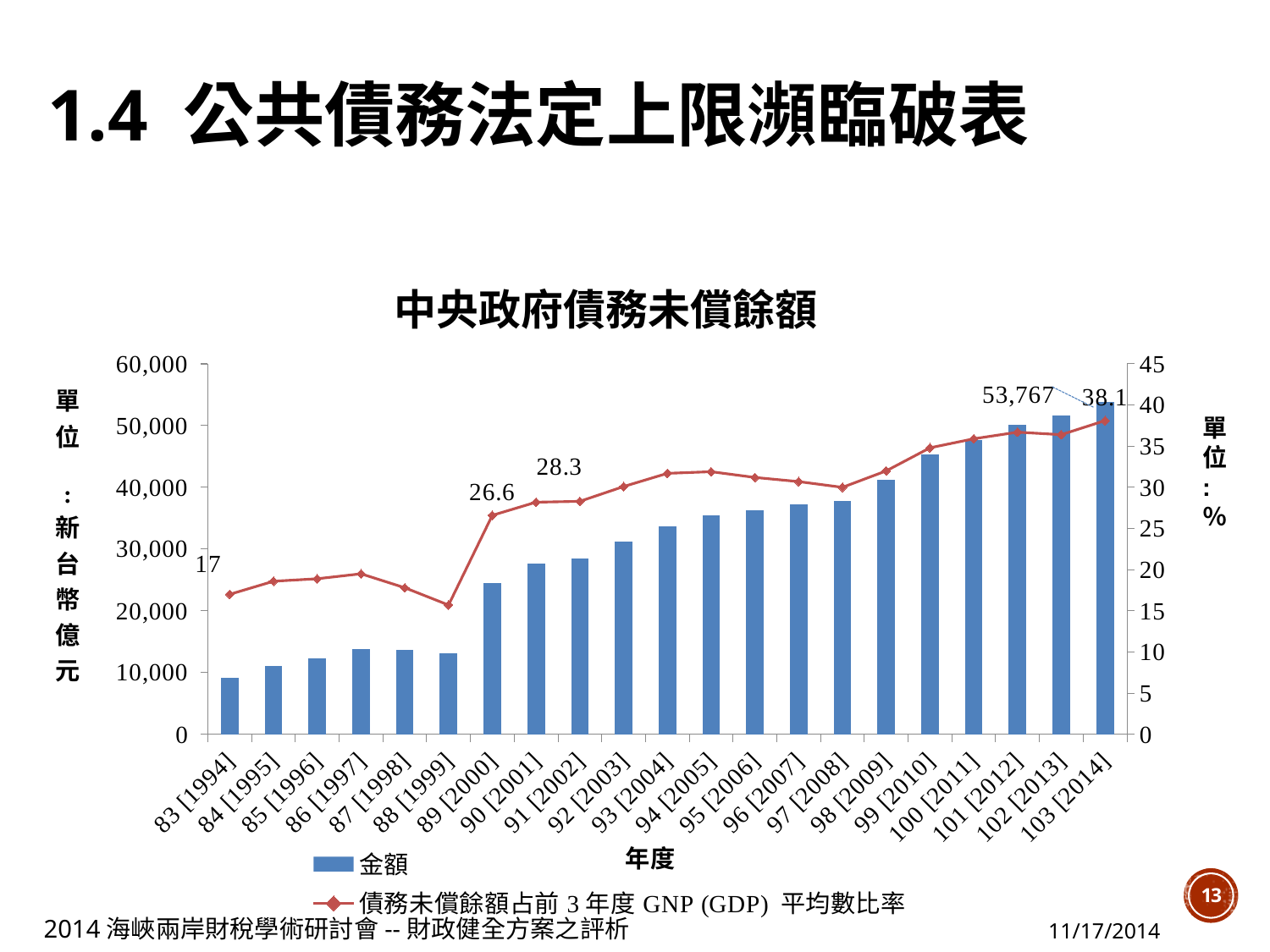
Which year has the highest 金額 bar? 103 [2014] What is the 金額 value for 103 [2014]? 53,767 What is the 債務未償餘額占前 3 年度 GNP (GDP) 平均數比率 value for 89 [2000]? 26.6 Is the 金額 value for 83 [1994] greater or less than 10,000? less Do the 金額 bars generally rise or fall from 83 [1994] to 103 [2014]? rise What is the 債務未償餘額占前 3 年度 GNP (GDP) 平均數比率 value for 83 [1994]? 17 How many years are shown on the x axis? 21 Which year has the lowest 金額 bar? 83 [1994] How many series does the legend list? 2 What is the 債務未償餘額占前 3 年度 GNP (GDP) 平均數比率 value for 103 [2014]? 38.1 By how much did the ratio value increase from 83 [1994] to 103 [2014]? 21.1